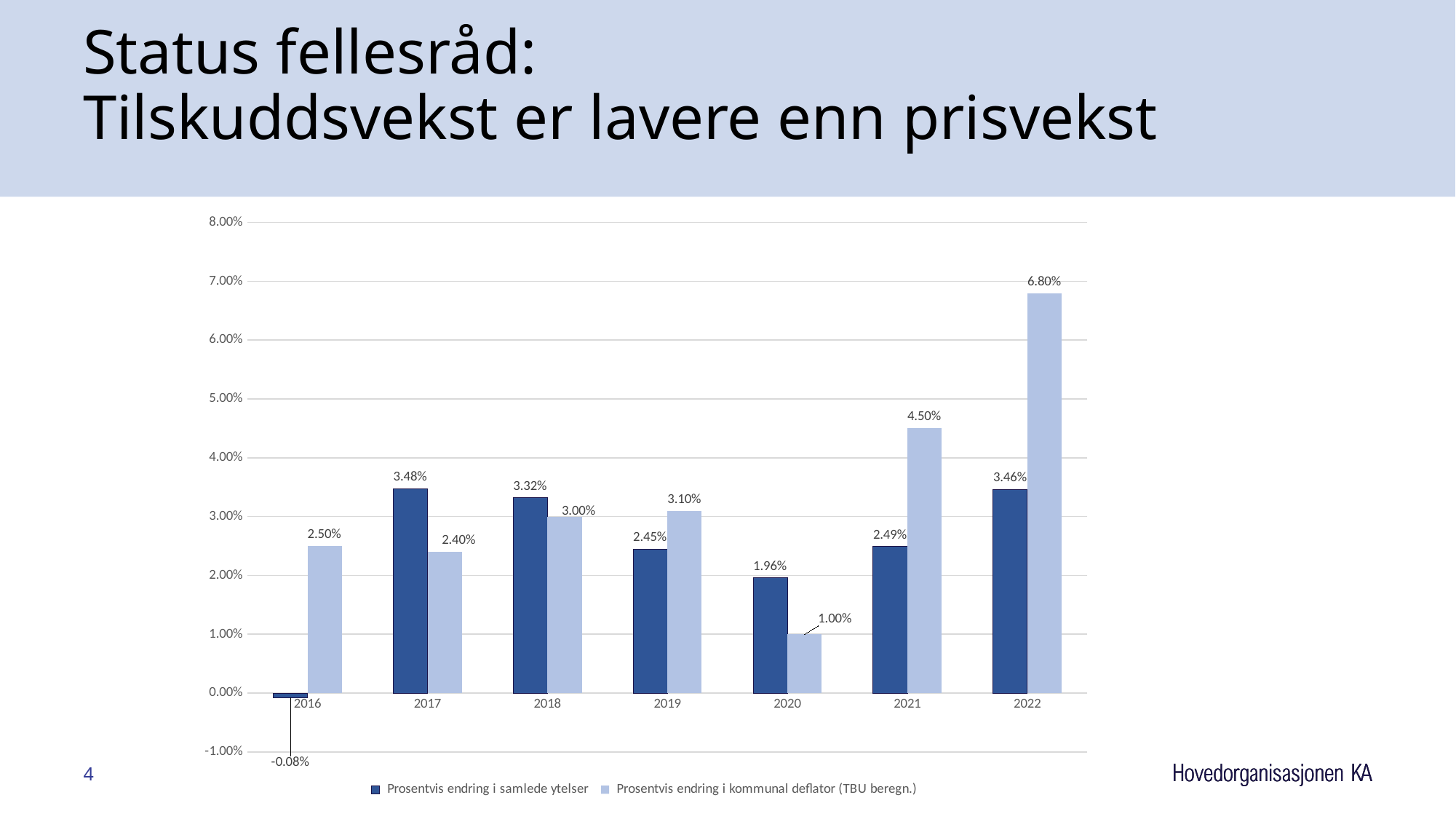
In which year is 'Prosentvis endring i kommunal deflator (TBU beregn.)' highest? 2022 In which year is 'Prosentvis endring i samlede ytelser' lowest? 2016 What is the value for 'Prosentvis endring i kommunal deflator (TBU beregn.)' in 2022? 6.80% What is the value for 'Prosentvis endring i kommunal deflator (TBU beregn.)' in 2020? 1.00% What is the value for 'Prosentvis endring i samlede ytelser' in 2016? -0.08% Is the value for 'Prosentvis endring i kommunal deflator (TBU beregn.)' in 2021 greater or less than 4.00%? greater How many years are shown on the x axis? 7 What is the difference between 'Prosentvis endring i kommunal deflator (TBU beregn.)' and 'Prosentvis endring i samlede ytelser' in 2022? 3.34% In 2018, which series has the larger value: 'Prosentvis endring i samlede ytelser' or 'Prosentvis endring i kommunal deflator (TBU beregn.)'? Prosentvis endring i samlede ytelser How many series does the legend list? 2 What kind of chart is shown on the slide? Bar chart What is the value for 'Prosentvis endring i samlede ytelser' in 2017? 3.48%